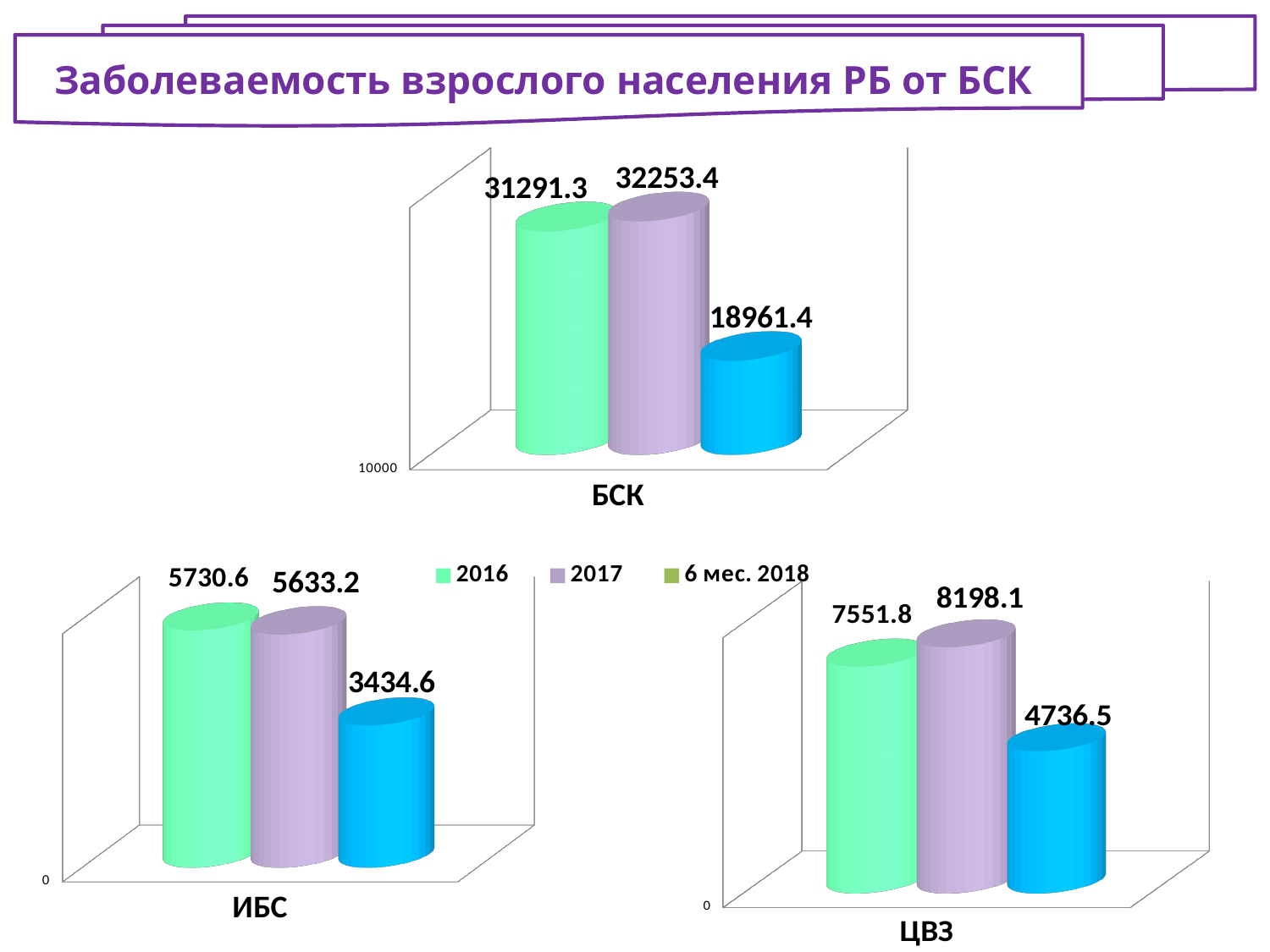
In the ИБС chart, what is the value for 2016? 5730.6 In the БСК chart, what is the value for 6 мес. 2018? 18961.4 In the БСК chart, what is the difference between the 2017 value and the 2016 value? 962.1 What is the title of the slide? Заболеваемость взрослого населения РБ от БСК In the ЦВЗ chart, what is the difference between the 2017 value and the 6 мес. 2018 value? 3461.6 How many series does the legend list? 3 In the ЦВЗ chart, which series has the highest value? 2017 In the БСК chart, what is the value for 2017? 32253.4 In the ИБС chart, which is larger, the value for 2016 or the value for 2017? 2016 In the ЦВЗ chart, what is the value for 6 мес. 2018? 4736.5 In the ИБС chart, which series has the lowest value? 6 мес. 2018 What kind of chart is the ЦВЗ chart? Bar chart